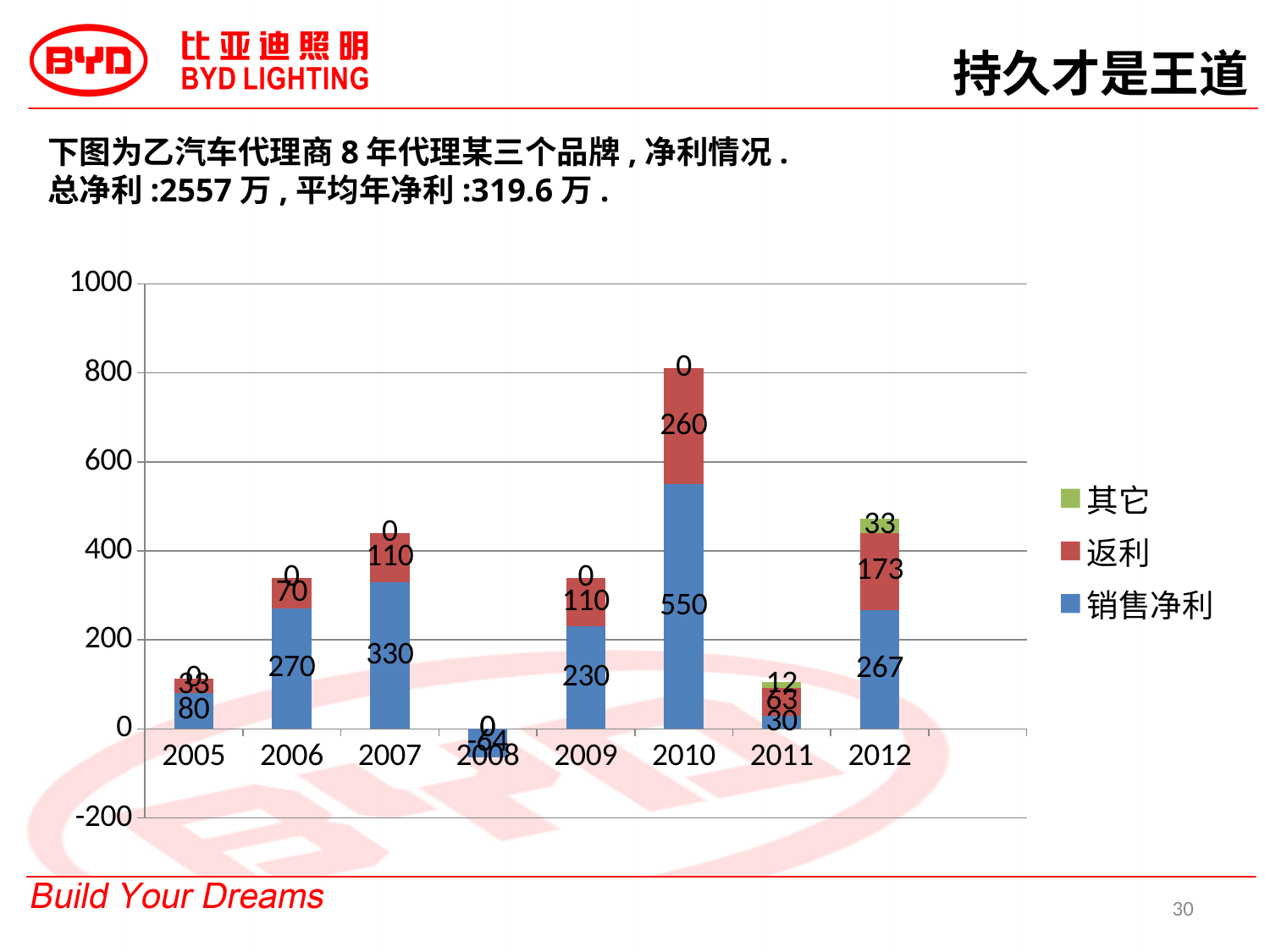
What is the value of 销售净利 for 2007? 330 What is the value of 销售净利 for 2010? 550 How many years are shown on the x axis? 8 What kind of chart is shown on the slide? bar chart What is the difference between the 返利 values for 2010 and 2006? 190 What is the value of 返利 for 2012? 173 Which year has the lowest 销售净利 value? 2008 Which year has the highest 销售净利 value? 2010 What is the value of 其它 for 2011? 12 Which is larger, the 销售净利 value for 2006 or for 2009? 2006 What is the total of the stacked bar for 2012? 473 How many series does the legend list? 3